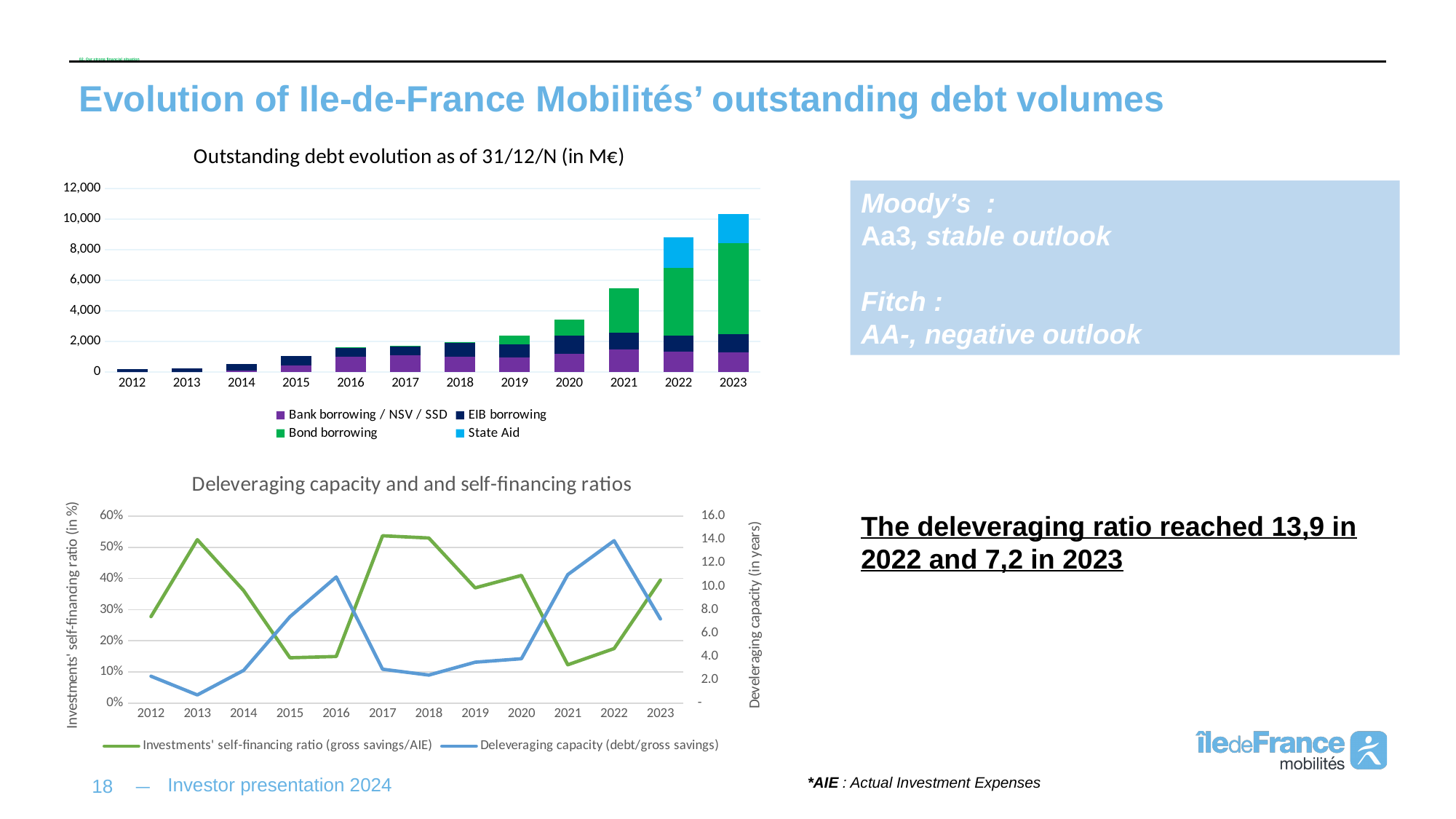
In the top chart 'Outstanding debt evolution as of 31/12/N (in M€)', how many years are shown on the x axis? 12 In the top chart 'Outstanding debt evolution as of 31/12/N (in M€)', how many series does the legend list? 4 In the bottom chart 'Deleveraging capacity and and self-financing ratios', in which year is the deleveraging capacity (debt/gross savings) lowest? 2013 In the bottom chart 'Deleveraging capacity and and self-financing ratios', is the investments' self-financing ratio for 2019 greater or less than 30%? greater What kind of chart is the top chart, 'Outstanding debt evolution as of 31/12/N (in M€)'? Bar chart In the bottom chart 'Deleveraging capacity and and self-financing ratios', how many series does the legend list? 2 In the top chart 'Outstanding debt evolution as of 31/12/N (in M€)', is the total outstanding debt for 2021 greater or less than 6,000? less In the top chart 'Outstanding debt evolution as of 31/12/N (in M€)', which series is shown in light blue? State Aid What kind of chart is the bottom chart, 'Deleveraging capacity and and self-financing ratios'? Line chart In the top chart 'Outstanding debt evolution as of 31/12/N (in M€)', which year has the highest total outstanding debt? 2023 In the top chart 'Outstanding debt evolution as of 31/12/N (in M€)', do the total outstanding debt values generally rise or fall from 2012 to 2023? Rise In the bottom chart 'Deleveraging capacity and and self-financing ratios', in which year is the deleveraging capacity (debt/gross savings) highest? 2022